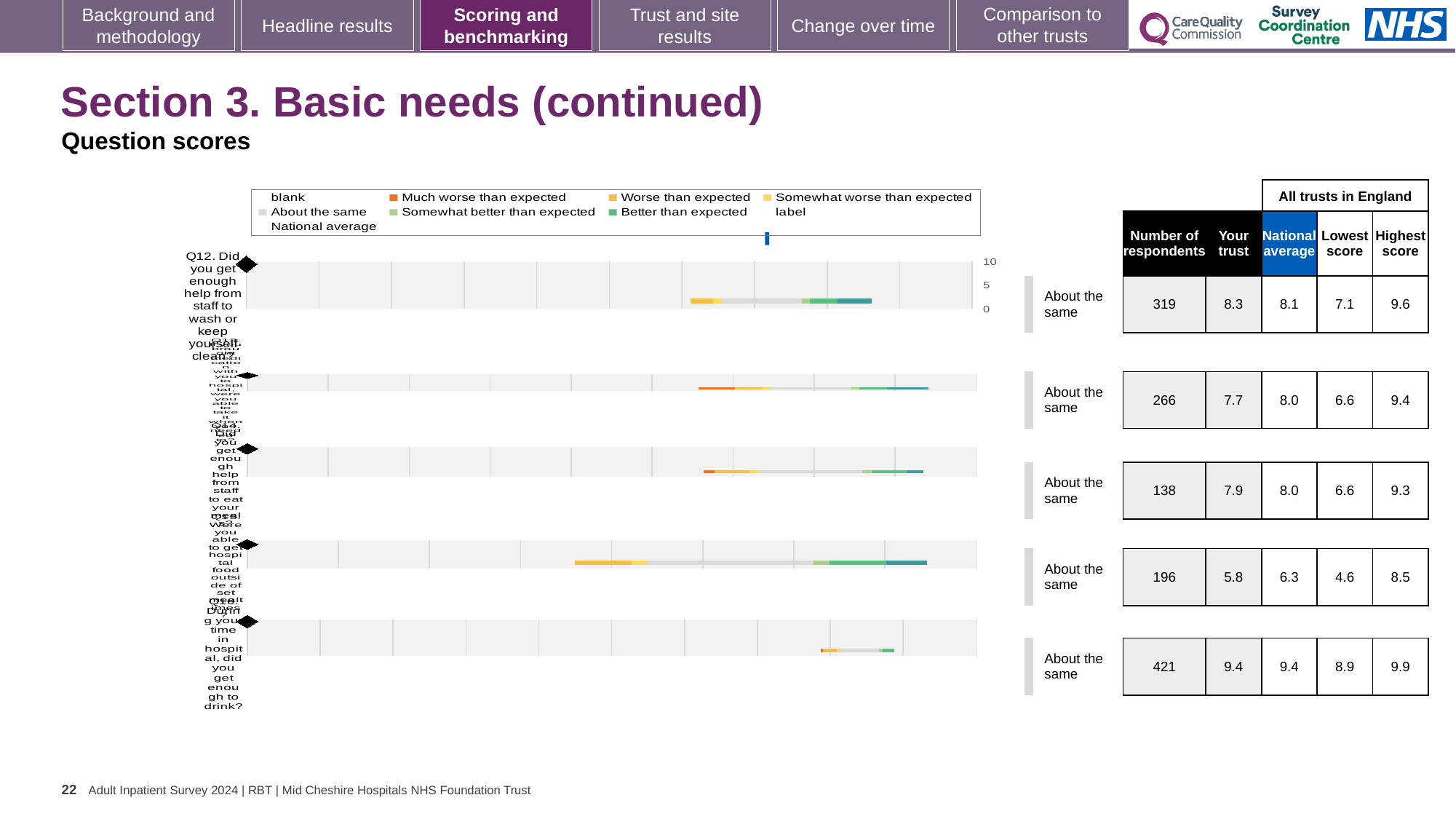
What kind of chart is shown on the slide? bar chart How many respondents are listed for Q12 (help from staff to wash or keep yourself clean)? 319 What benchmark category is shown for every question row on this slide? About the same How many survey questions (bars) are plotted in the chart? 5 For Q14 (help from staff to eat your meals), which is larger: the 'Your trust' score or the 'National average'? National average What is the 'Highest score' among all trusts in England for Q16 (did you get enough to drink?)? 9.9 Which question row has the highest 'Your trust' score? Q16 (did you get enough to drink?) What is the 'Your trust' score for Q12 (Did you get enough help from staff to wash or keep yourself clean?)? 8.3 What is the 'Lowest score' among all trusts in England for Q15 (hospital food outside of set meal times)? 4.6 What colour does the legend use for 'Much worse than expected'? orange What is the difference between the 'Your trust' score and the 'National average' for Q12? 0.2 Which question row has the lowest 'Your trust' score? Q15 (hospital food outside of set meal times)